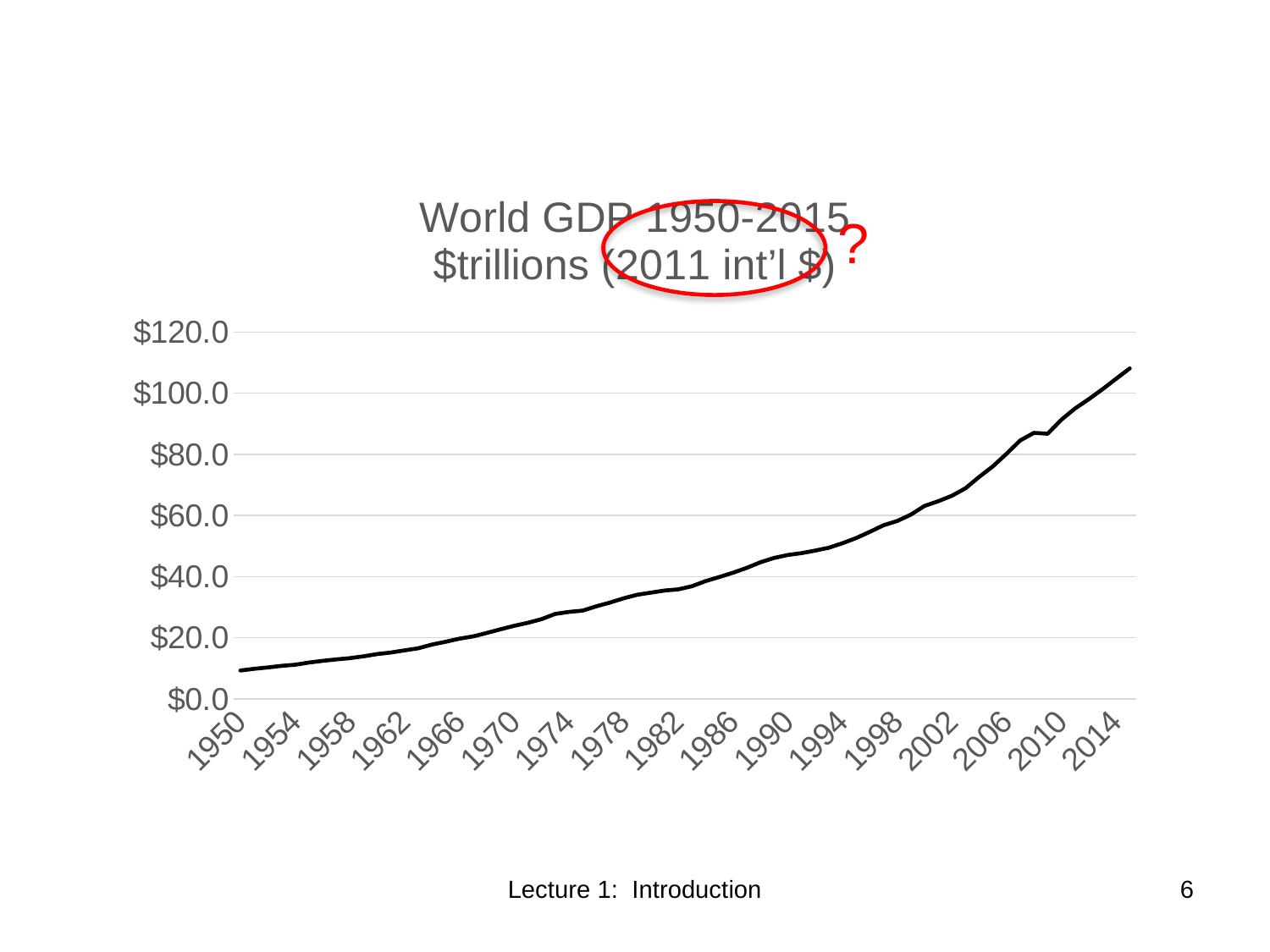
Which is larger, the value for 1966 or the value for 1994? 1994 Which year shown on the x axis has the lowest value? 1950 What kind of chart is shown on the slide? line chart Is the value for 1974 greater or less than $20.0? greater Is the value for 2010 greater or less than $80.0? greater Is the value for 2002 greater or less than $60.0? greater What is the title of the chart? World GDP 1950-2015 $trillions (2011 int'l $) Do the values rise or fall from 1950 to 2015? rise